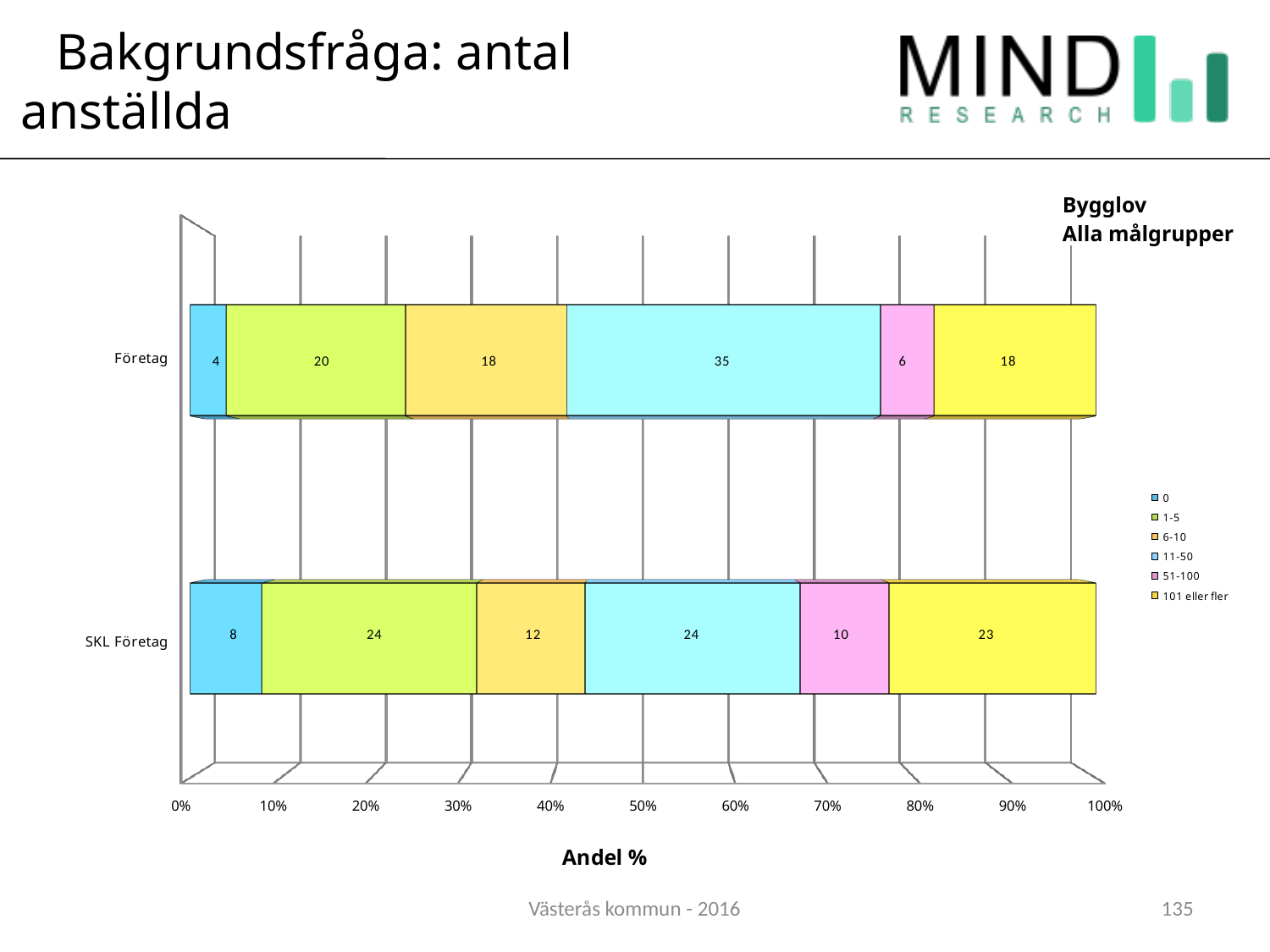
How many categories are shown on the vertical axis? 2 Which series has the lowest value in the SKL Företag bar? 0 What is the value for the 101 eller fler series in the SKL Företag bar? 23 What is the value for the 0 series in the Företag bar? 4 What kind of chart is shown on the slide? Stacked bar chart What is the value for the 11-50 series in the Företag bar? 35 What is the difference between the 11-50 values for Företag and SKL Företag? 11 What is the value for the 1-5 series in the SKL Företag bar? 24 Which is larger: the 51-100 value for Företag or for SKL Företag? SKL Företag What is the label of the horizontal axis? Andel % Which series has the highest value in the Företag bar? 11-50 How many series does the legend list? 6